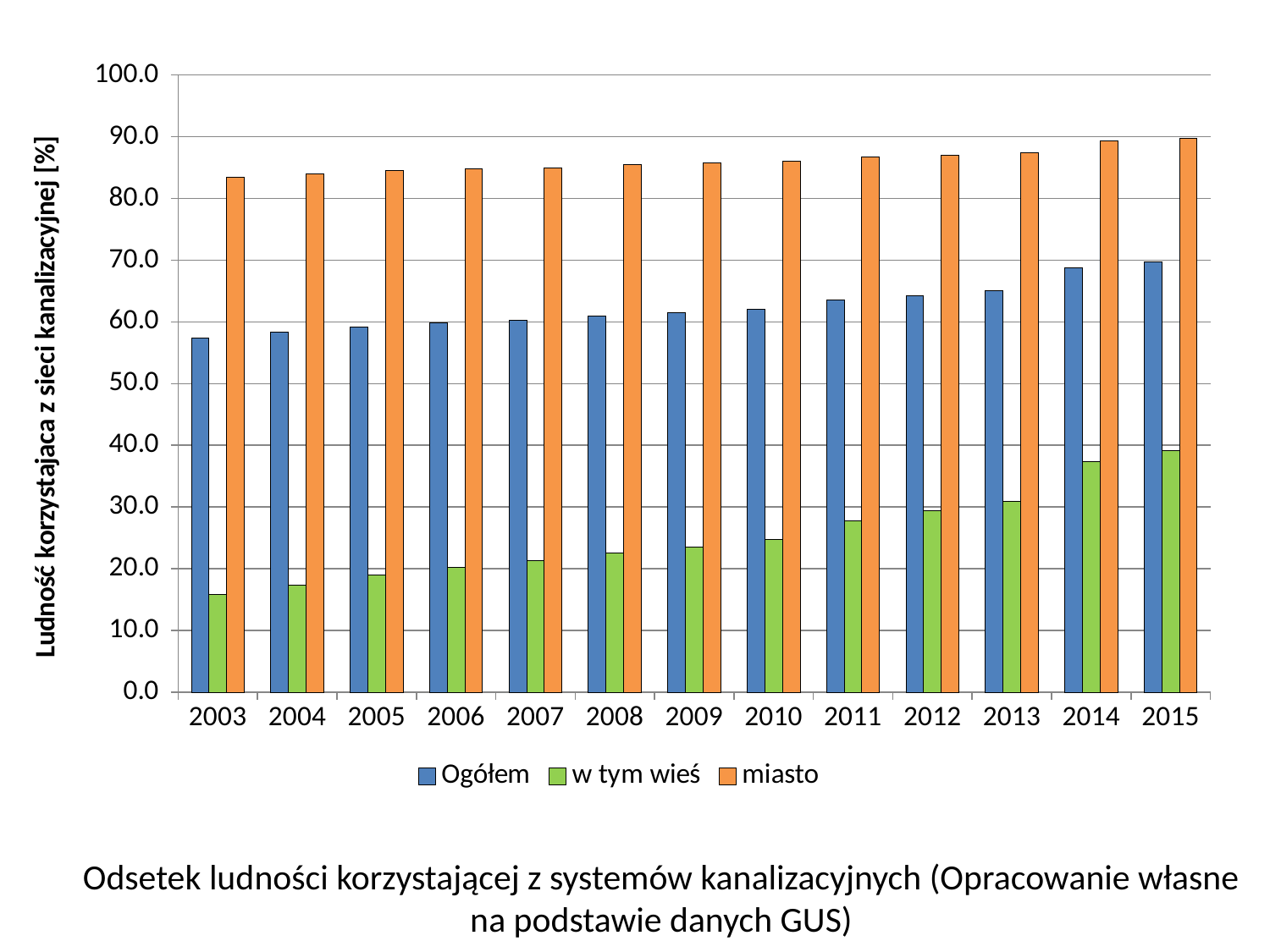
What kind of chart is shown on the slide? bar chart In 2015, which is larger: the value for 'Ogółem' or for 'w tym wieś'? Ogółem In which year is the value for 'w tym wieś' highest? 2015 Is the value for 'w tym wieś' in 2014 greater or less than 30.0? greater Is the value for 'Ogółem' in 2003 greater or less than 60.0? less What is the label of the y axis? Ludność korzystająca z sieci kanalizacyjnej [%] In which year is the value for 'Ogółem' lowest? 2003 How many series does the legend list? 3 Do the values for 'miasto' rise or fall from 2003 to 2015? rise Is the value for 'miasto' in 2003 greater or less than 80.0? greater How many years are shown on the x axis? 13